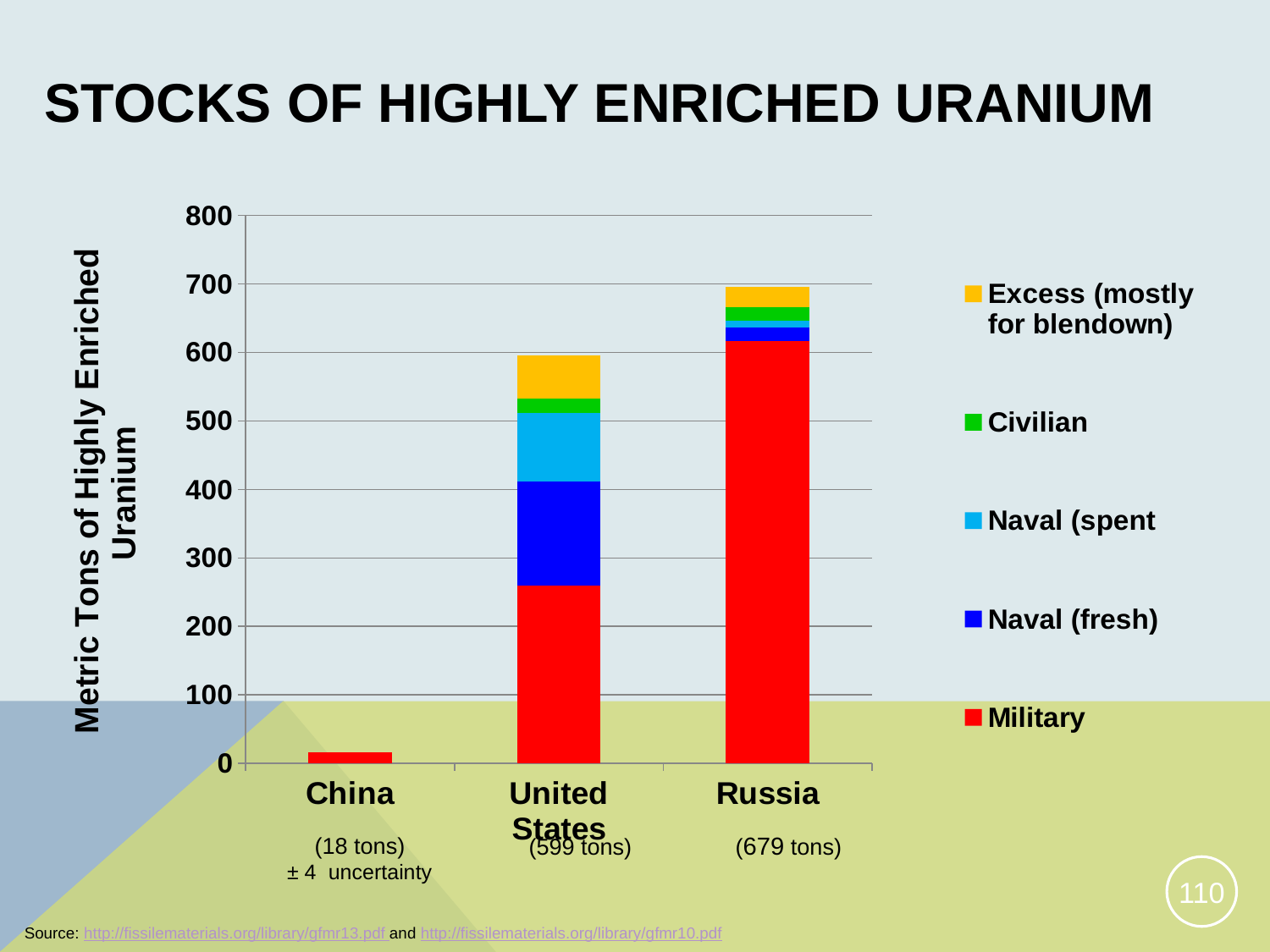
Is the Military segment for the United States greater or less than 200? greater What kind of chart is shown on the slide? Stacked bar chart Using the printed totals, how many more tons does Russia have than the United States? 80 tons How many countries are shown on the x axis of the chart? 3 What total is printed below the China bar? 18 tons Which country has the highest total stock of highly enriched uranium? Russia Is the Military segment for Russia greater or less than 600? greater Which country has the lowest total stock of highly enriched uranium? China What total is printed below the Russia bar? 679 tons What total is printed below the United States bar? 599 tons What is the title of the y axis? Metric Tons of Highly Enriched Uranium How many series does the legend list? 5